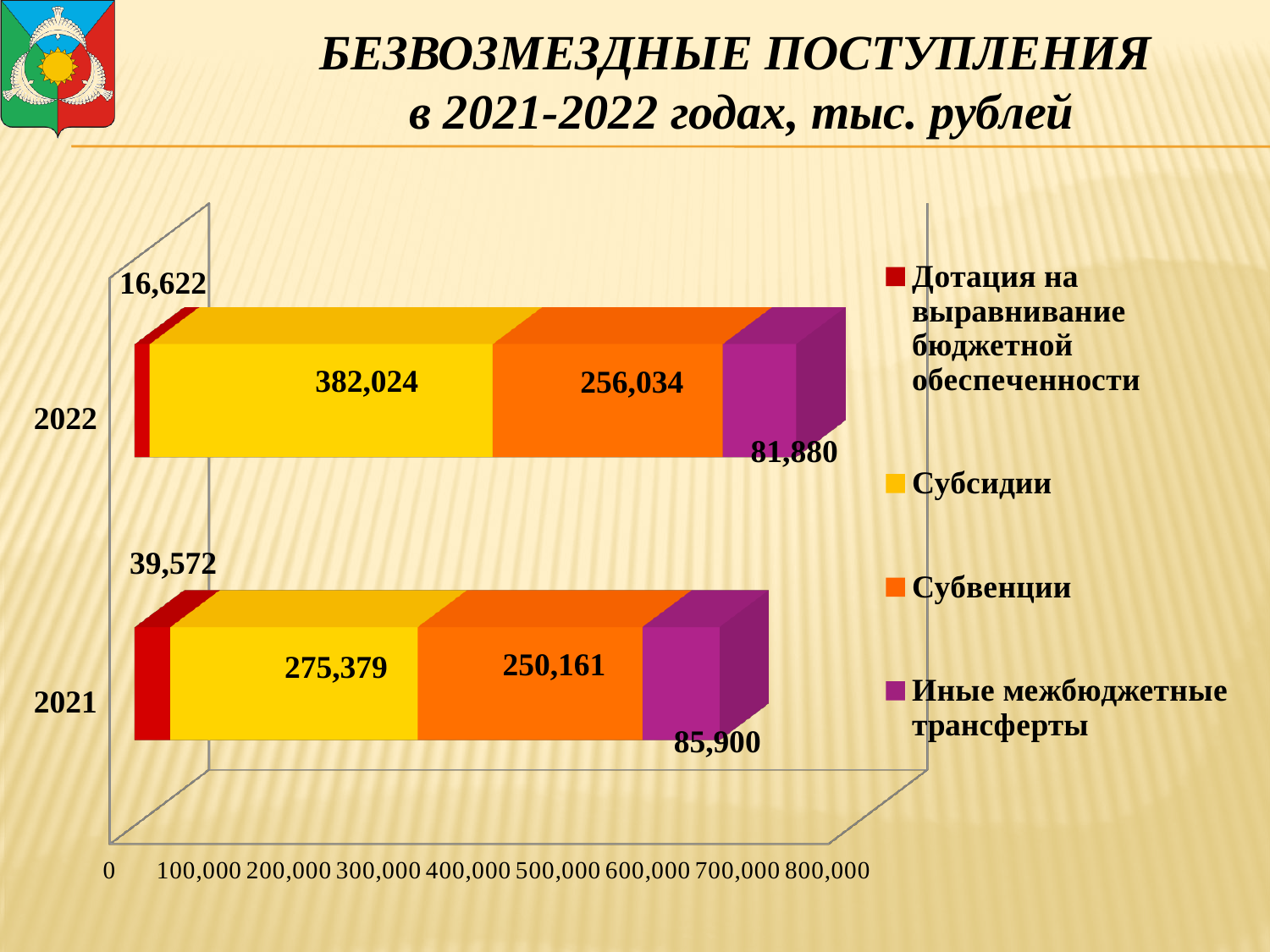
Which year has the larger value for Дотация на выравнивание бюджетной обеспеченности, 2021 or 2022? 2021 What type of chart is shown on the slide? stacked bar chart Which series has the lowest value in 2022? Дотация на выравнивание бюджетной обеспеченности What is the value of Иные межбюджетные трансферты for 2022? 81,880 How many series does the legend list? 4 What is the value of Дотация на выравнивание бюджетной обеспеченности for 2021? 39,572 What is the value of Субвенции for 2021? 250,161 By how much did Субсидии increase from 2021 to 2022? 106,645 Which series has the highest value in 2022? Субсидии What is the value of Субсидии for 2022? 382,024 What is the total of the stacked bar for 2022? 736,560 How many years (categories) are plotted on the chart? 2